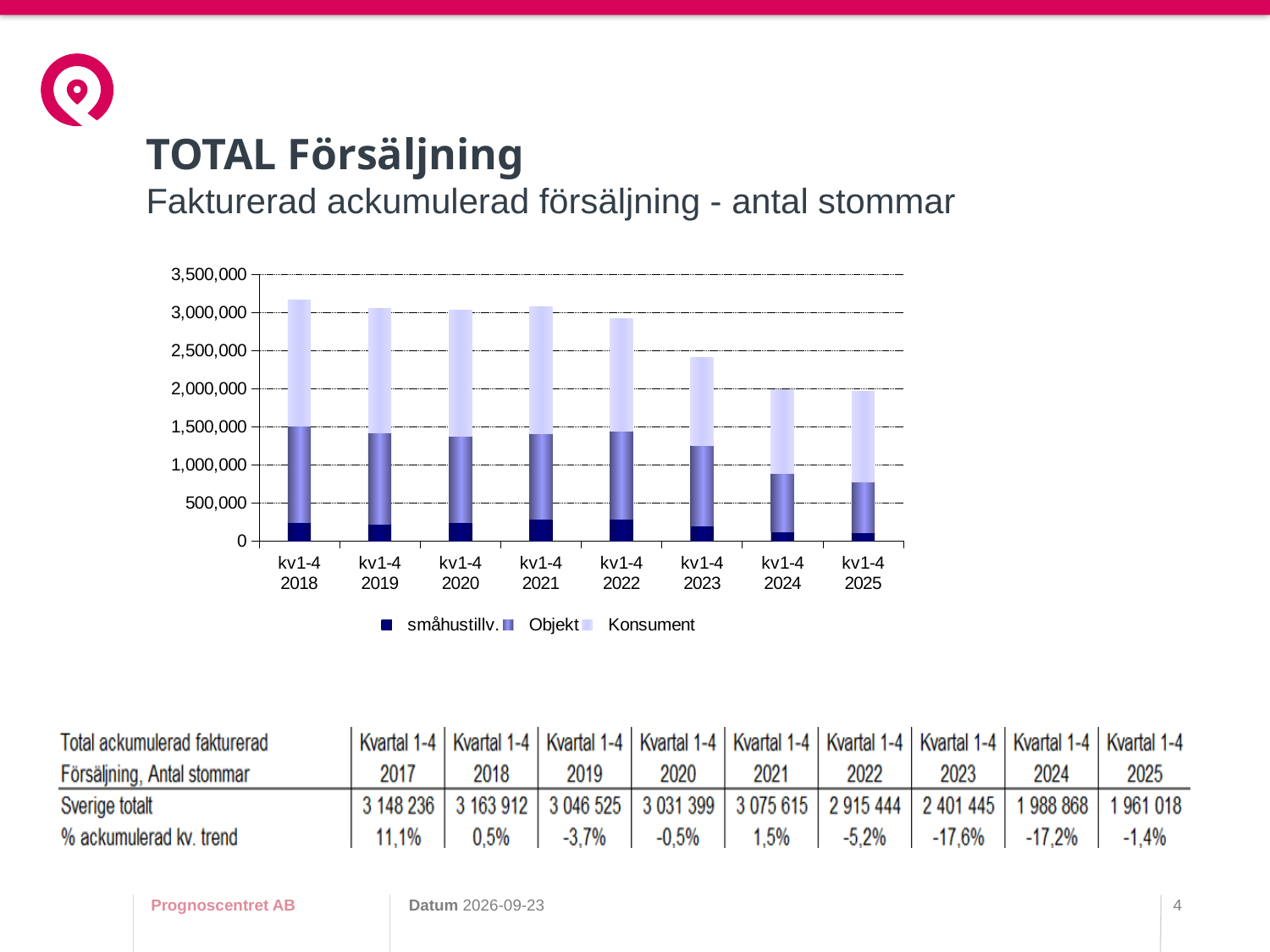
Which series are listed in the chart legend? småhustillv., Objekt, Konsument How many series does the chart legend list? 3 Is the total bar for kv1-4 2023 greater or less than 2,500,000? less How many bars (periods) are plotted in the chart? 8 According to the table, what is the % ackumulerad kv. trend for Kvartal 1-4 2024? -17,2% What kind of chart is shown on the slide? Stacked bar chart Is the total bar for kv1-4 2018 greater or less than 3,000,000? greater According to the table, what is the Sverige totalt value for Kvartal 1-4 2023? 2 401 445 Do the total bars generally rise or fall from 2018 to 2025? fall Which period has the highest total bar in the chart? kv1-4 2018 Using the table values, what is the difference between Sverige totalt for Kvartal 1-4 2018 and Kvartal 1-4 2025? 1 202 894 Which total bar is larger, kv1-4 2022 or kv1-4 2023? kv1-4 2022